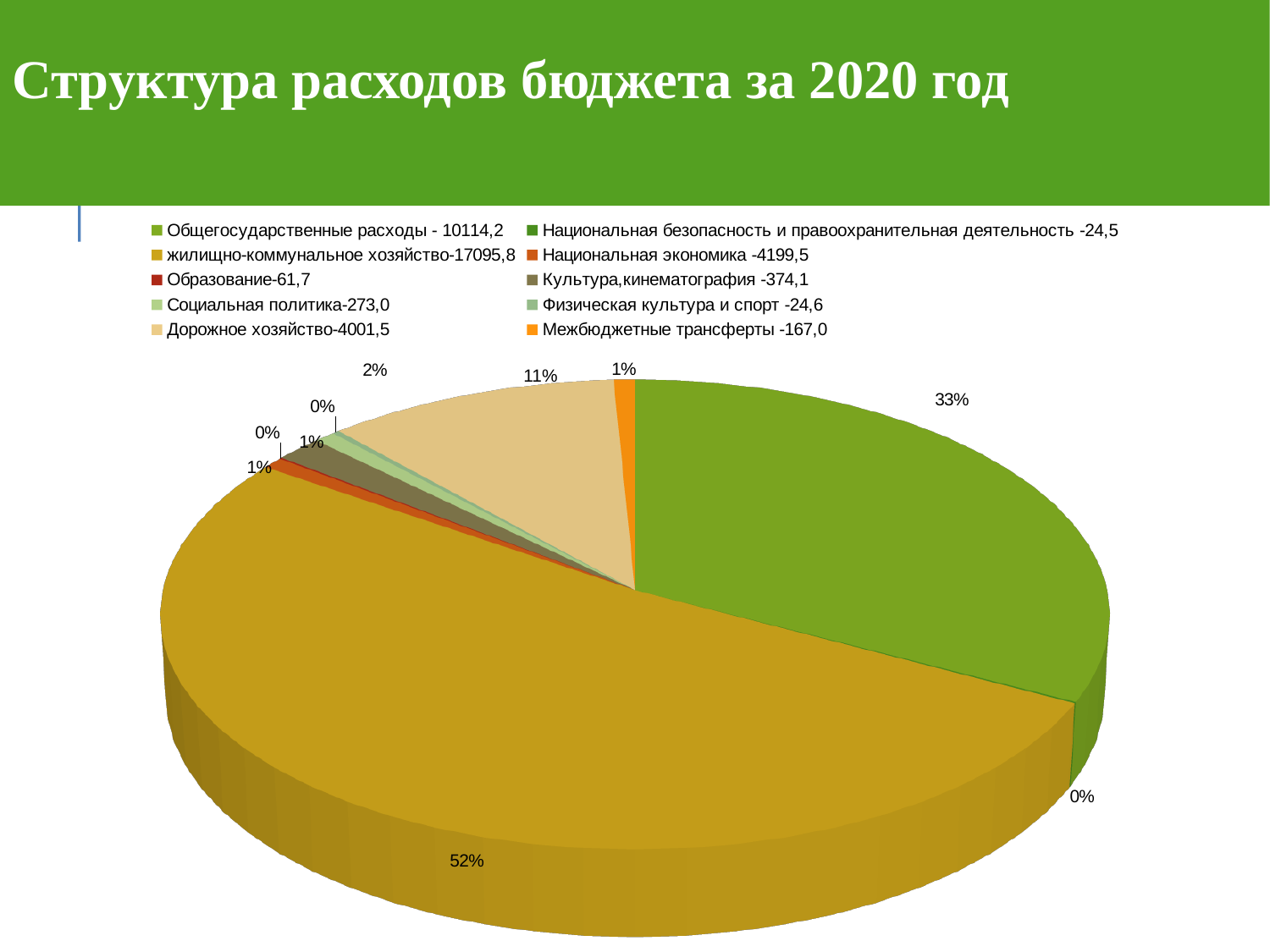
What kind of chart is shown on the slide? pie chart What share of the pie does Дорожное хозяйство have? 11% What share of the pie does Общегосударственные расходы have? 33% What is the difference in percentage points between the share for жилищно-коммунальное хозяйство and the share for Общегосударственные расходы? 19% Which is larger: the share for Общегосударственные расходы or for жилищно-коммунальное хозяйство? жилищно-коммунальное хозяйство How many entries does the legend list? 10 What share of the pie does жилищно-коммунальное хозяйство have? 52% What is the title of the slide's chart? Структура расходов бюджета за 2020 год What value is listed in the legend for Национальная экономика? 4199,5 What value is listed in the legend for Межбюджетные трансферты? 167,0 What value is listed in the legend for Образование? 61,7 Which category has the largest share of the pie? жилищно-коммунальное хозяйство